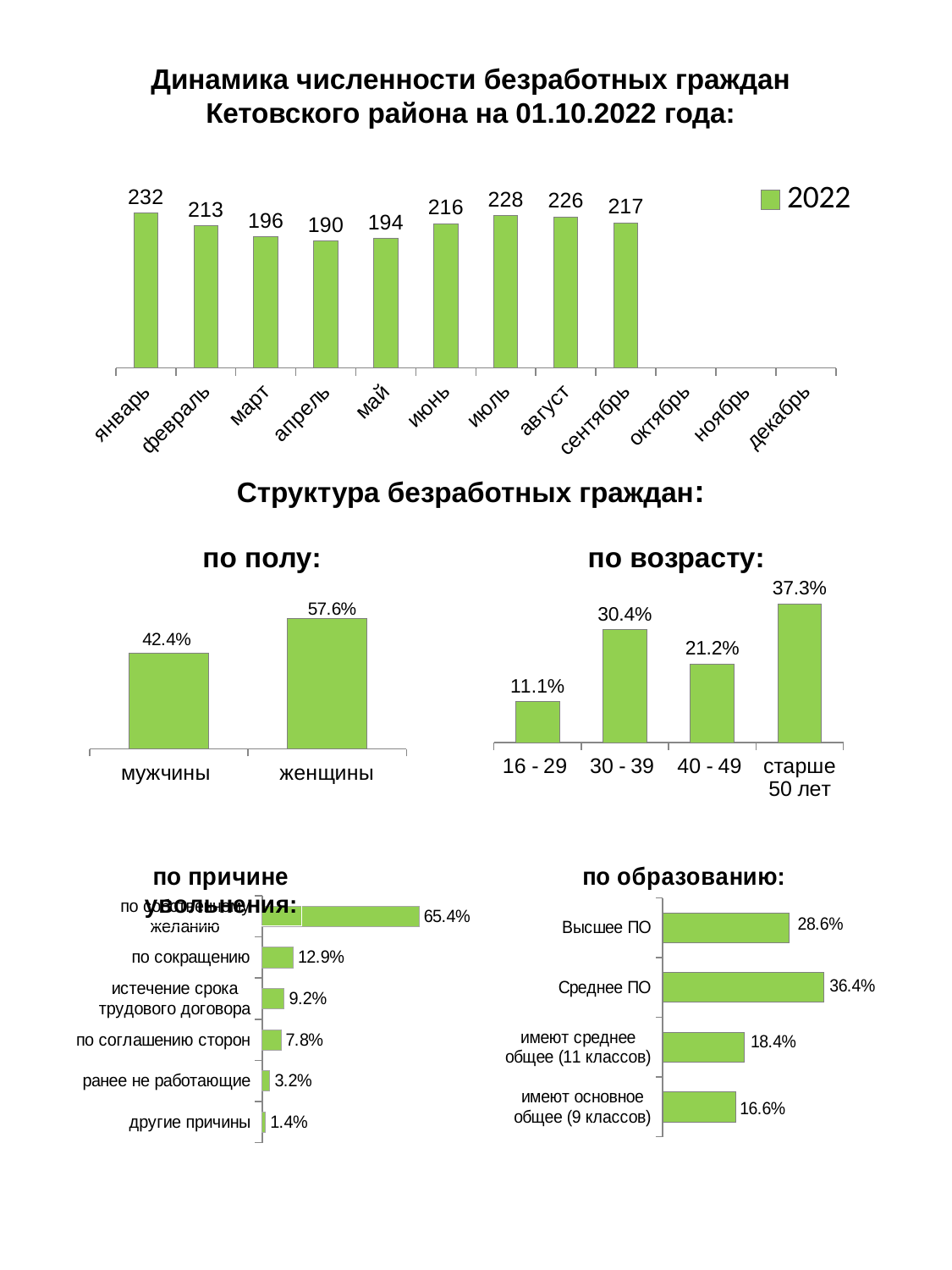
In the top chart 'Динамика численности безработных граждан', which month has the lowest value? апрель In the chart 'по возрасту', which age group has the highest value? старше 50 лет In the chart 'по причине увольнения', what is the value for по сокращению? 12.9% In the top chart 'Динамика численности безработных граждан', how many months have a bar plotted? 9 What kind of chart is 'по образованию'? bar chart In the top chart 'Динамика численности безработных граждан', what is the value for январь? 232 In the chart 'по возрасту', what is the value for 40 - 49? 21.2% In the chart 'по образованию', which is larger: Высшее ПО or Среднее ПО? Среднее ПО In the chart 'по причине увольнения', which category has the lowest value? другие причины In the top chart 'Динамика численности безработных граждан', how many series does the legend list? 1 In the top chart 'Динамика численности безработных граждан', what is the difference between the values for июль and март? 32 In the chart 'по полу', what is the value for женщины? 57.6%